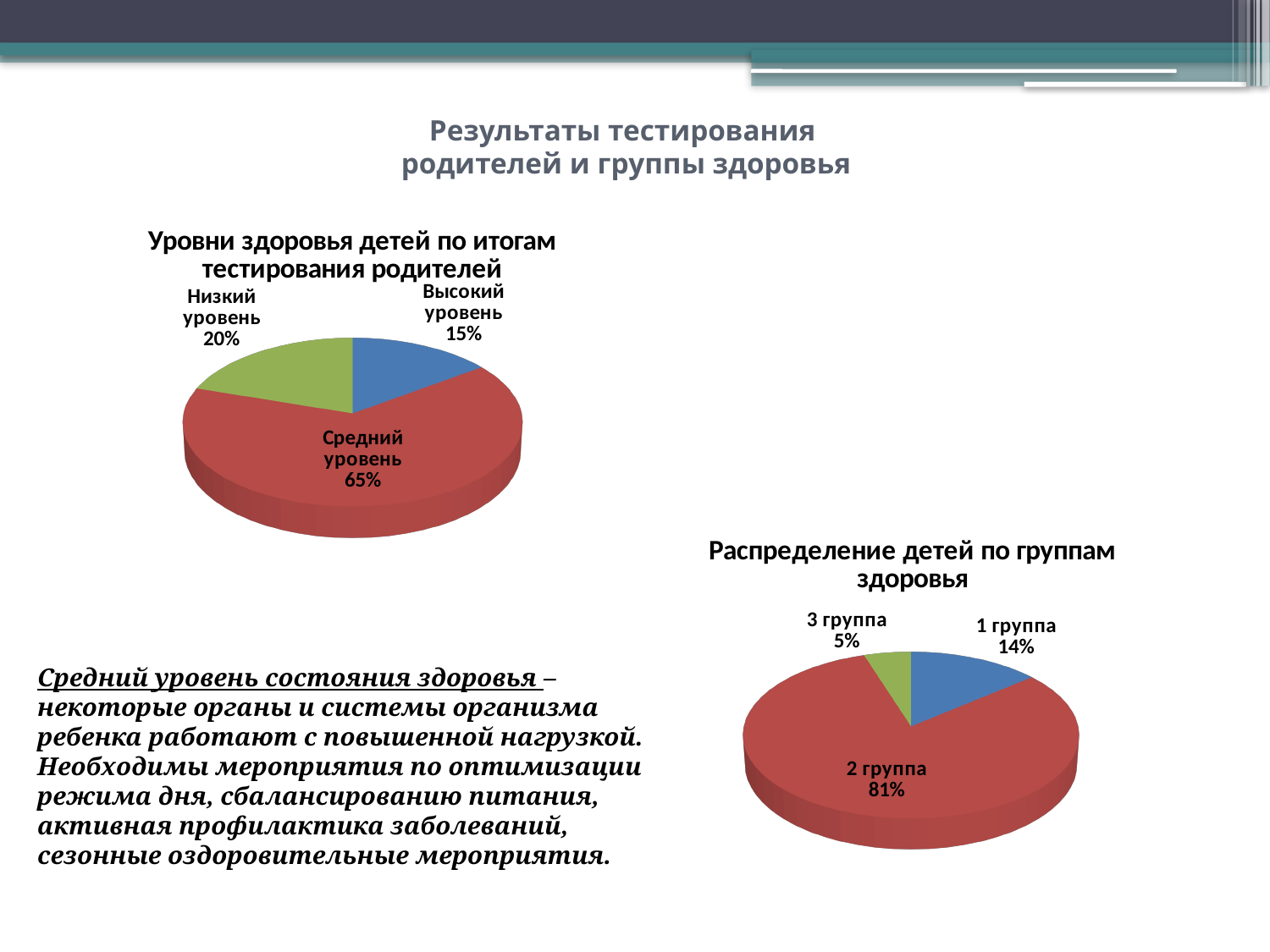
In the chart titled "Уровни здоровья детей по итогам тестирования родителей", how many slices does the pie have? 3 In the chart titled "Уровни здоровья детей по итогам тестирования родителей", what share is labelled for "Средний уровень"? 65% In the chart titled "Уровни здоровья детей по итогам тестирования родителей", how many percentage points larger is "Средний уровень" than "Низкий уровень"? 45 In the chart titled "Распределение детей по группам здоровья", which is larger: "1 группа" or "3 группа"? 1 группа In the chart titled "Уровни здоровья детей по итогам тестирования родителей", which category has the largest slice? Средний уровень In the chart titled "Уровни здоровья детей по итогам тестирования родителей", what share is labelled for "Низкий уровень"? 20% In the chart titled "Распределение детей по группам здоровья", what colour is the slice for "2 группа"? Red In the chart titled "Распределение детей по группам здоровья", which group has the smallest slice? 3 группа In the chart titled "Распределение детей по группам здоровья", what share is labelled for "2 группа"? 81% What kind of chart is the chart titled "Распределение детей по группам здоровья"? Pie chart In the chart titled "Распределение детей по группам здоровья", what share is labelled for "3 группа"? 5% In the chart titled "Уровни здоровья детей по итогам тестирования родителей", which category has the smallest slice? Высокий уровень